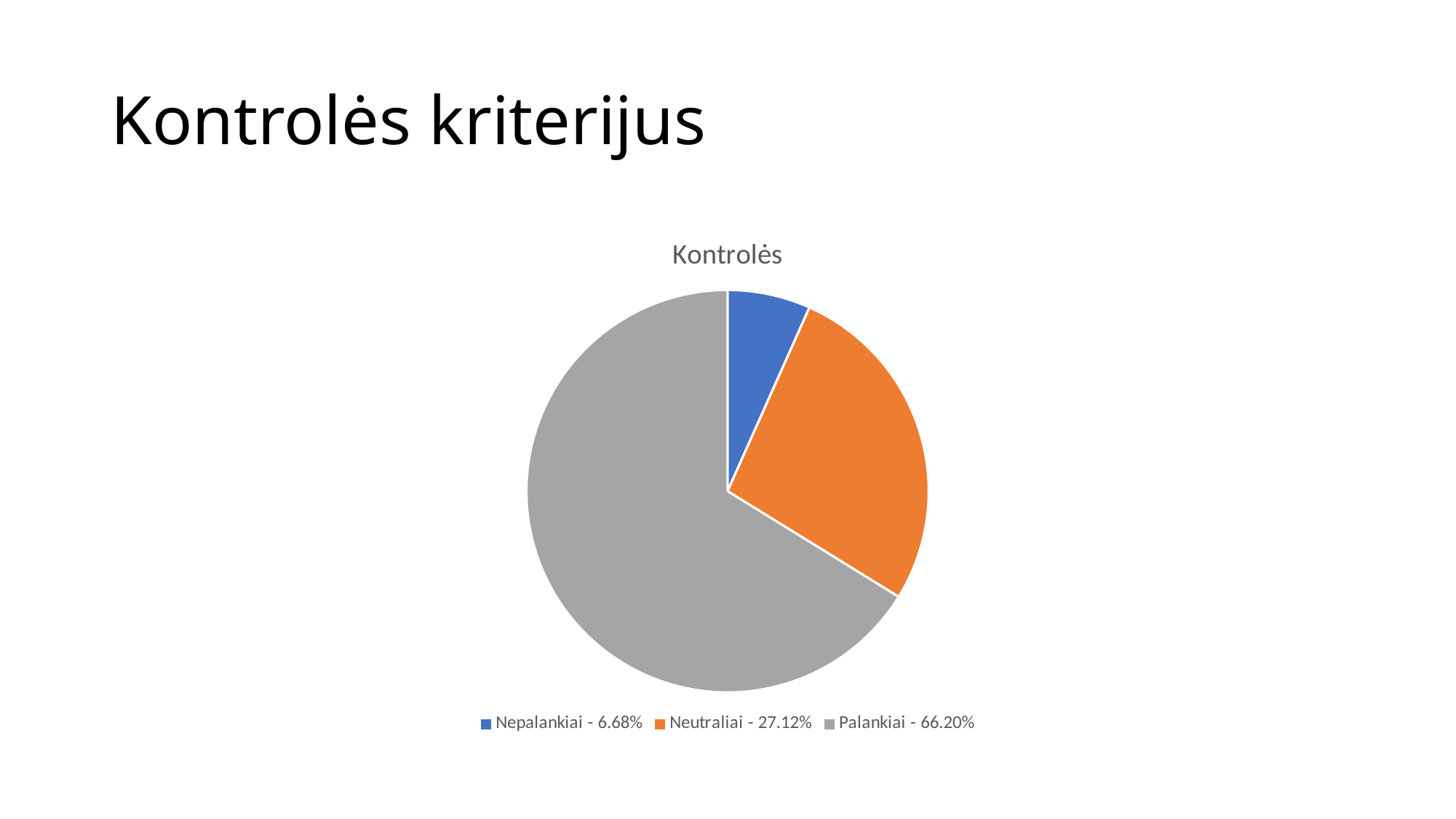
Which category has the smallest slice of the pie? Nepalankiai What type of chart is shown on the slide? pie chart What is the difference in percentage points between the Neutraliai and Nepalankiai slices? 20.44 How many slices does the pie chart have? 3 What share of the pie does the Neutraliai slice represent? 27.12% What colour is the Palankiai slice in the pie chart? grey What is the title of the chart? Kontrolės What share of the pie does the Palankiai slice represent? 66.20% Which category has the largest slice of the pie? Palankiai What is the difference in percentage points between the Palankiai and Neutraliai slices? 39.08 Which is larger, the Neutraliai slice or the Nepalankiai slice? Neutraliai What share of the pie does the Nepalankiai slice represent? 6.68%